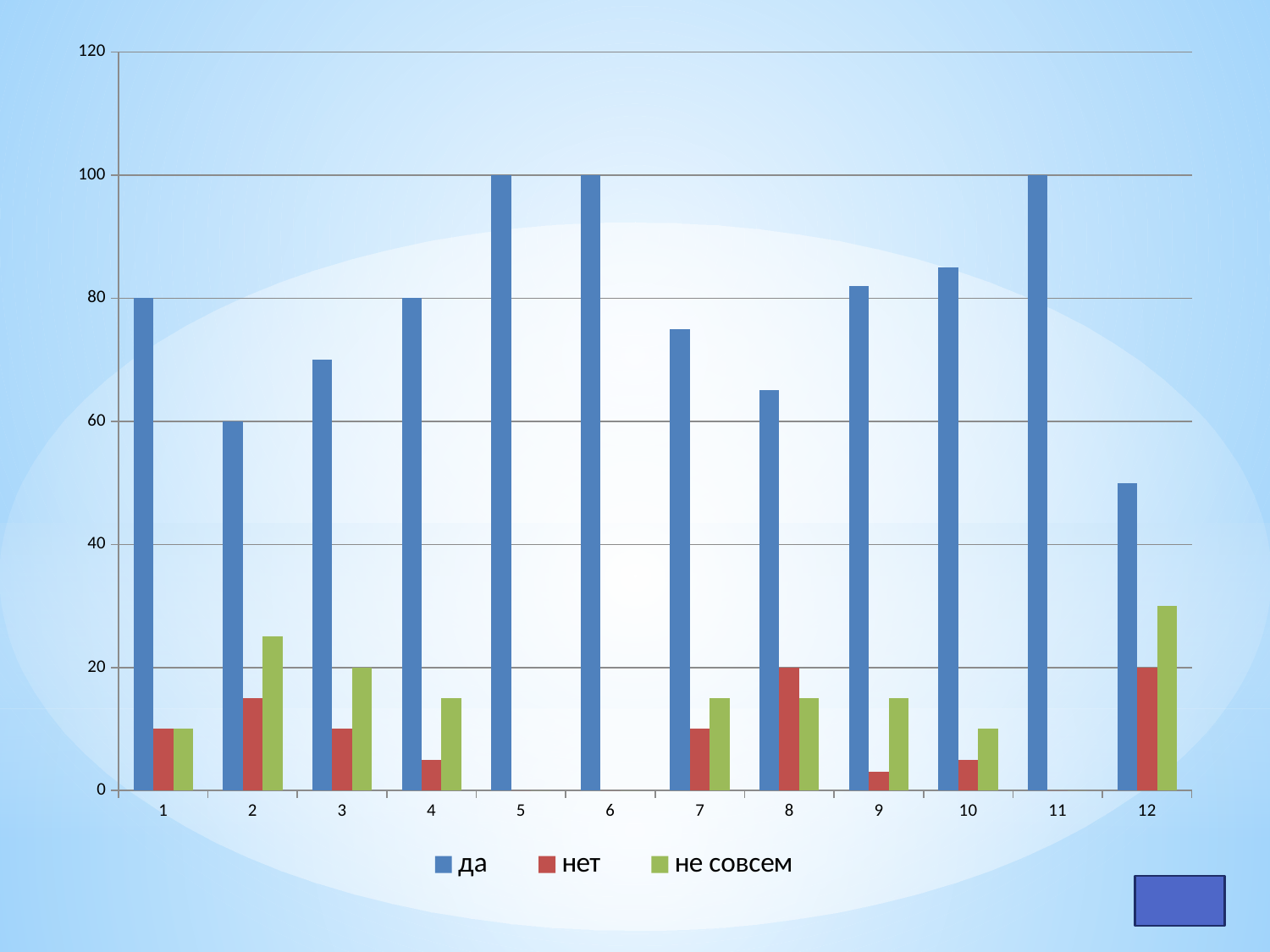
What is the value of "да" for category 1? 80 How many series does the legend list? 3 Is the "да" value for category 10 greater or less than 80? greater What is the value of "да" for category 2? 60 What kind of chart is shown on the slide? bar chart What is the value of "да" for category 5? 100 Which is larger, the "да" value for category 7 or for category 8? category 7 Which category has the highest "не совсем" value? 12 Which category has the lowest "да" value? 12 How many categories are shown on the x axis? 12 What is the difference between the "да" values for category 1 and category 2? 20 What is the value of "нет" for category 8? 20